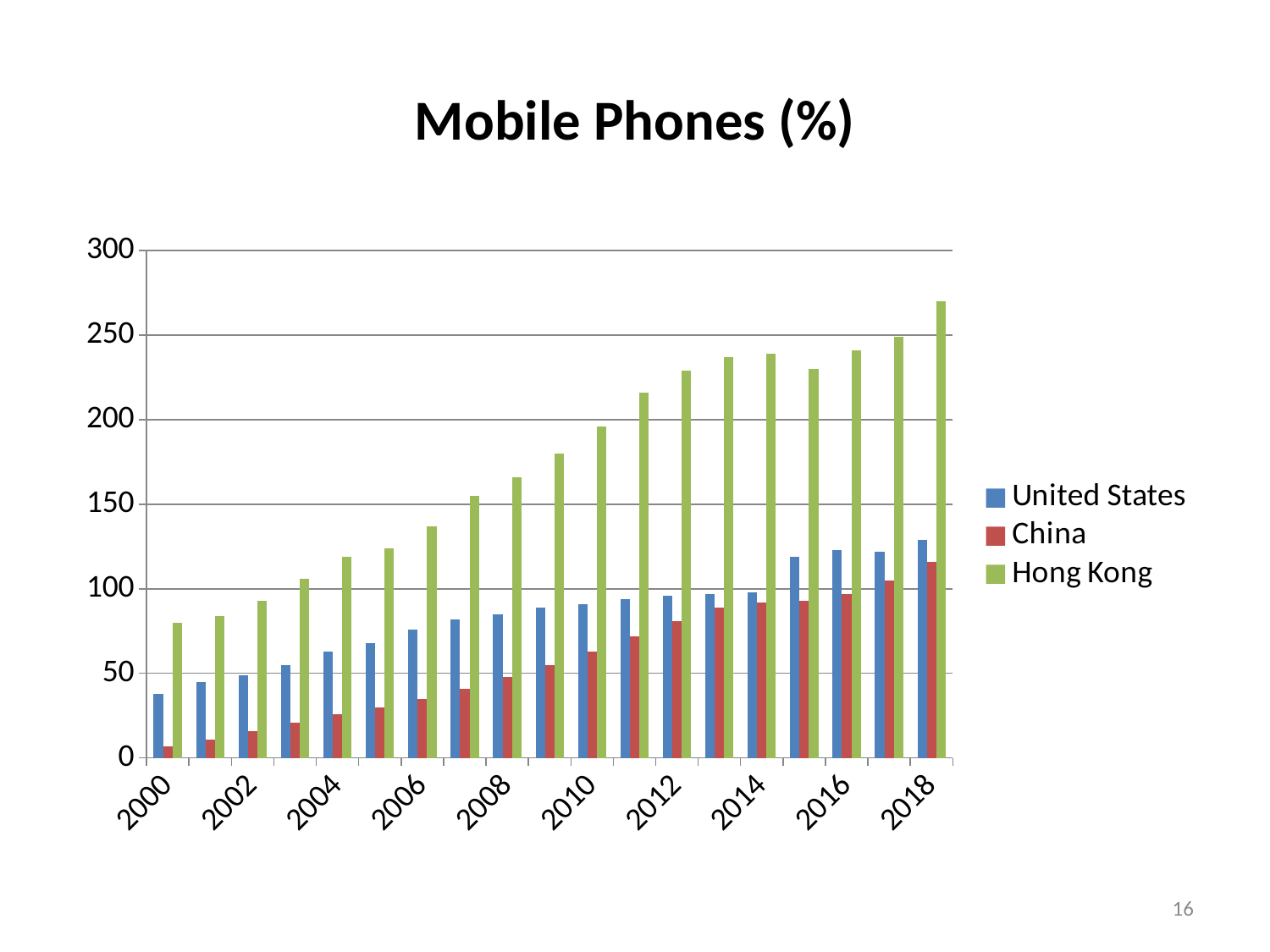
What is the title of the chart? Mobile Phones (%) What kind of chart is shown on the slide? bar chart Do the values for China generally rise or fall from 2000 to 2018? rise Is the value for Hong Kong in 2000 greater or less than 100? less In which year does Hong Kong reach its highest value? 2018 In 2010, which is larger: the value for Hong Kong or the value for United States? Hong Kong Is the value for Hong Kong in 2018 greater or less than 250? greater How many series does the legend list? 3 Is the value for China in 2000 greater or less than 50? less In which year is the value for China lowest? 2000 Which colour represents Hong Kong in the chart? green